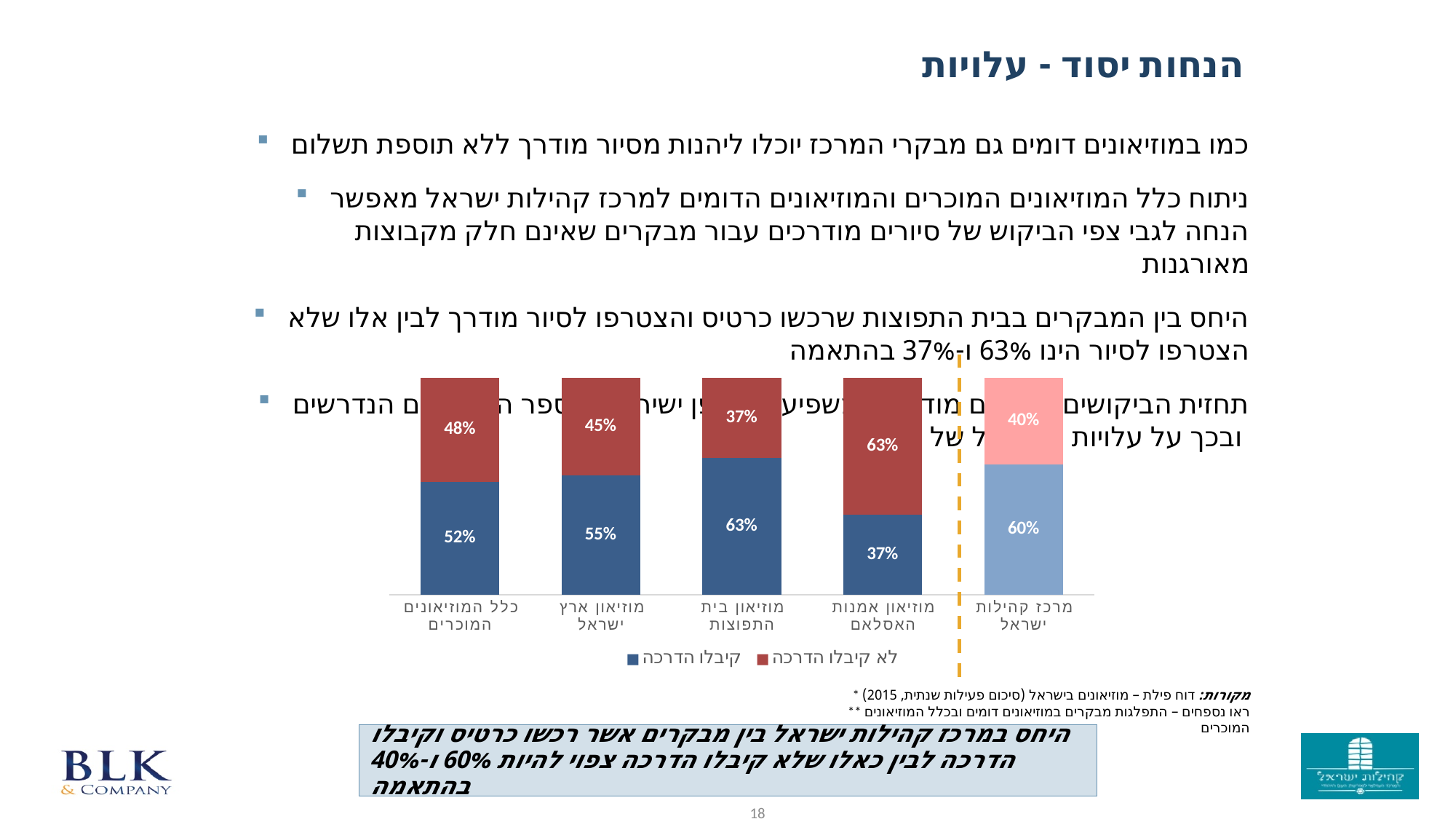
What is the value of קיבלו הדרכה for מוזיאון אמנות האסלאם? 37% Which category has the lowest value for לא קיבלו הדרכה? מוזיאון בית התפוצות How many categories (bars) does the chart show? 5 Which category has the highest value for קיבלו הדרכה? מוזיאון בית התפוצות What is the value of לא קיבלו הדרכה for מרכז קהילות ישראל? 40% What is the value of לא קיבלו הדרכה for מוזיאון בית התפוצות? 37% How many series does the chart legend list? 2 What is the difference between the לא קיבלו הדרכה values for מוזיאון ארץ ישראל and מוזיאון אמנות האסלאם? 18% What is the value of קיבלו הדרכה for כלל המוזיאונים המוכרים? 52% What kind of chart is shown on the slide? stacked bar chart Which series is shown in red in the chart legend? לא קיבלו הדרכה Which is larger: the קיבלו הדרכה value for מוזיאון ארץ ישראל or for מוזיאון בית התפוצות? מוזיאון בית התפוצות